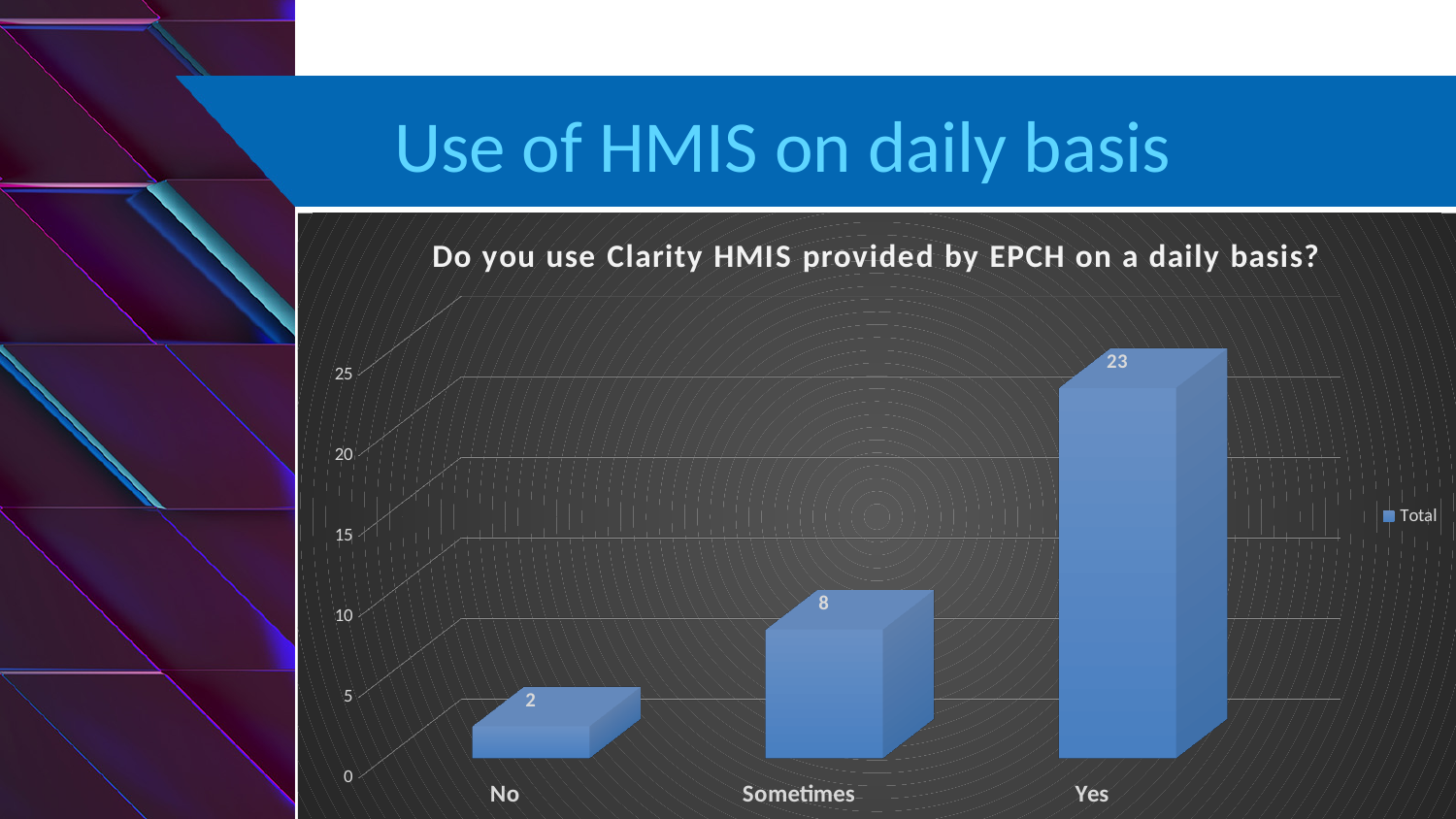
What is the difference between the values for "Yes" and "Sometimes"? 15 Is the value for "Yes" greater or less than 20? greater Which is larger, the value for "Sometimes" or the value for "No"? Sometimes What is the value for "No"? 2 What kind of chart is shown on the slide? Bar chart What is the difference between the values for "Sometimes" and "No"? 6 What is the value for "Yes"? 23 Which category has the highest value? Yes How many categories are shown on the x axis? 3 What is the title of the chart? Do you use Clarity HMIS provided by EPCH on a daily basis? What is the value for "Sometimes"? 8 Which category has the lowest value? No